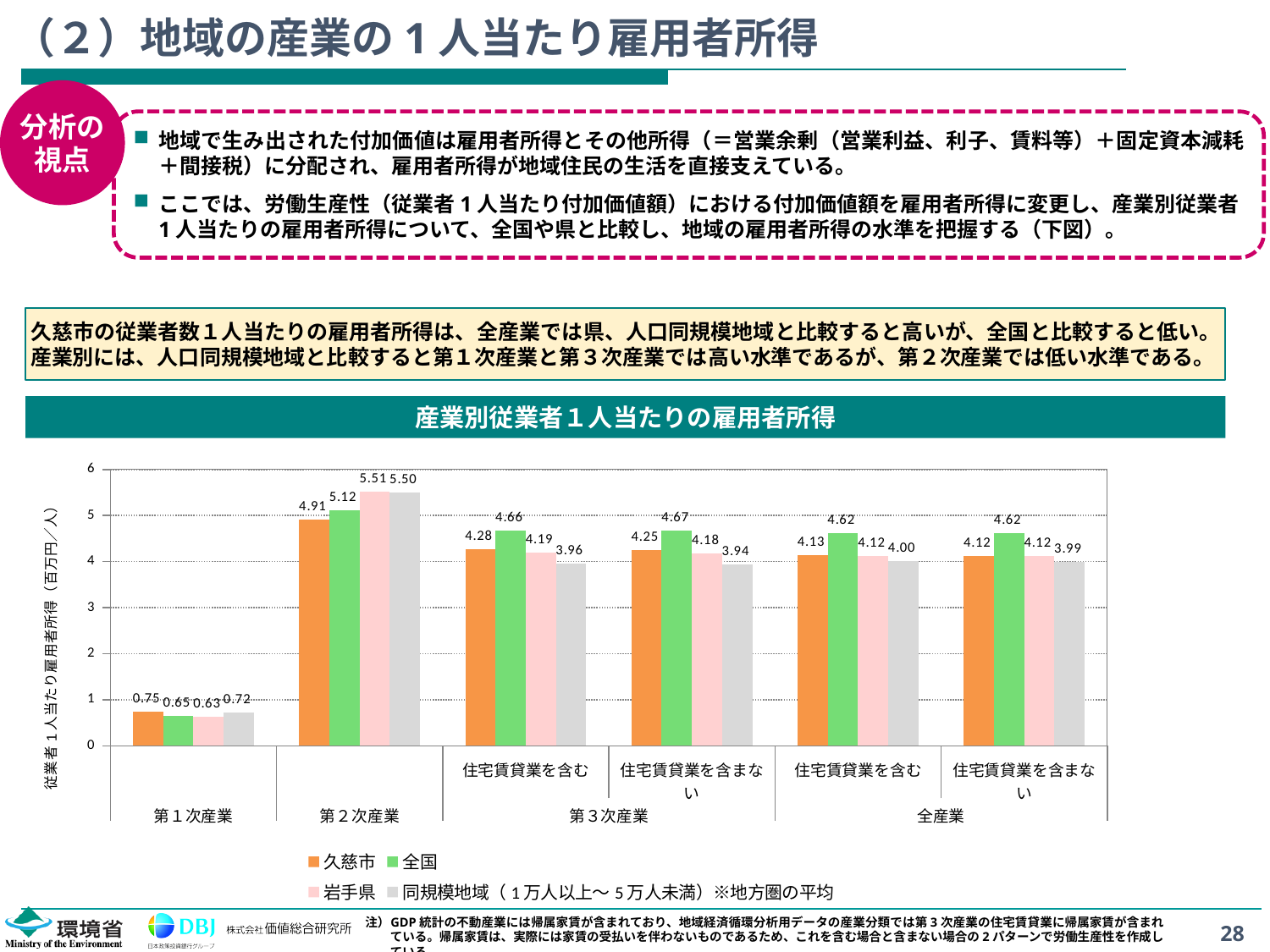
凡例にはいくつの系列が示されていますか？ 4 第３次産業（住宅賃貸業を含む）における全国の値はいくらですか？ 4.66 グラフの縦軸のラベルは何ですか？ 従業者１人当たり雇用者所得（百万円／人） 全産業（住宅賃貸業を含む）において、久慈市と全国ではどちらの値が大きいですか？ 全国 このグラフはどの種類のグラフですか？ 棒グラフ 第３次産業（住宅賃貸業を含む）における久慈市と同規模地域の値の差はいくらですか？ 0.32 第２次産業における岩手県の値はいくらですか？ 5.51 第１次産業における久慈市の従業者１人当たり雇用者所得はいくらですか？ 0.75 第２次産業において、4つの系列のうち最も値が低いのはどれですか？ 久慈市 全産業（住宅賃貸業を含まない）における同規模地域の値はいくらですか？ 3.99 第２次産業における久慈市の値は5より大きいですか、小さいですか？ 小さい 第１次産業において、4つの系列のうち最も値が高いのはどれですか？ 久慈市